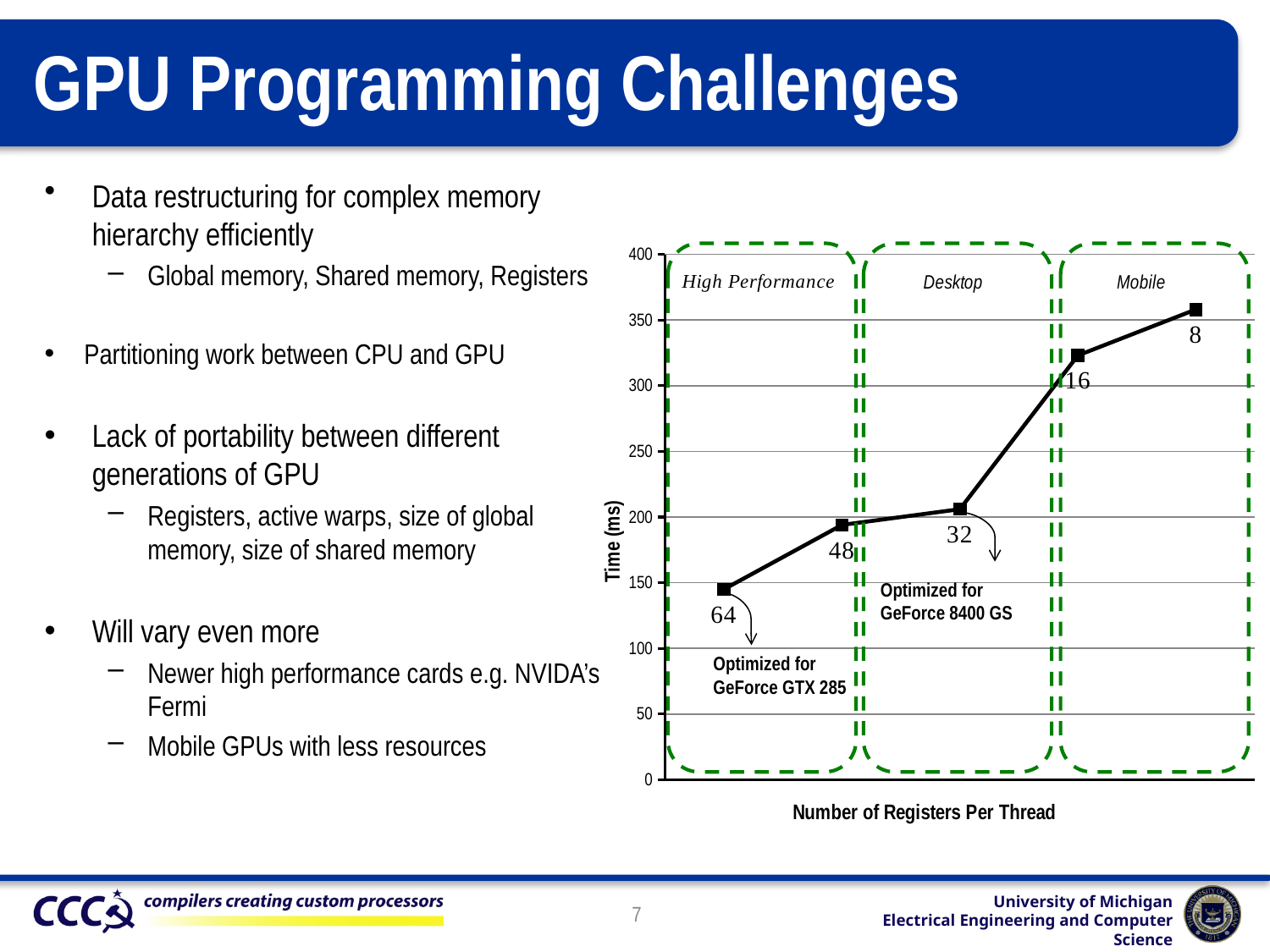
Is the time for 48 registers per thread greater or less than 150 ms? greater How many data points are plotted on the chart? 5 Is the time for 8 registers per thread greater or less than 300 ms? greater Which GPU is the 64-registers-per-thread point labelled as optimized for? GeForce GTX 285 What kind of chart is shown on the slide? line chart What is the label of the y axis? Time (ms) Does the time rise or fall as you move from left to right along the x axis? rise Which number of registers per thread has the highest time? 8 Is the time for 64 registers per thread greater or less than 100 ms? greater Which has a higher time, 16 registers per thread or 32 registers per thread? 16 Which number of registers per thread has the lowest time? 64